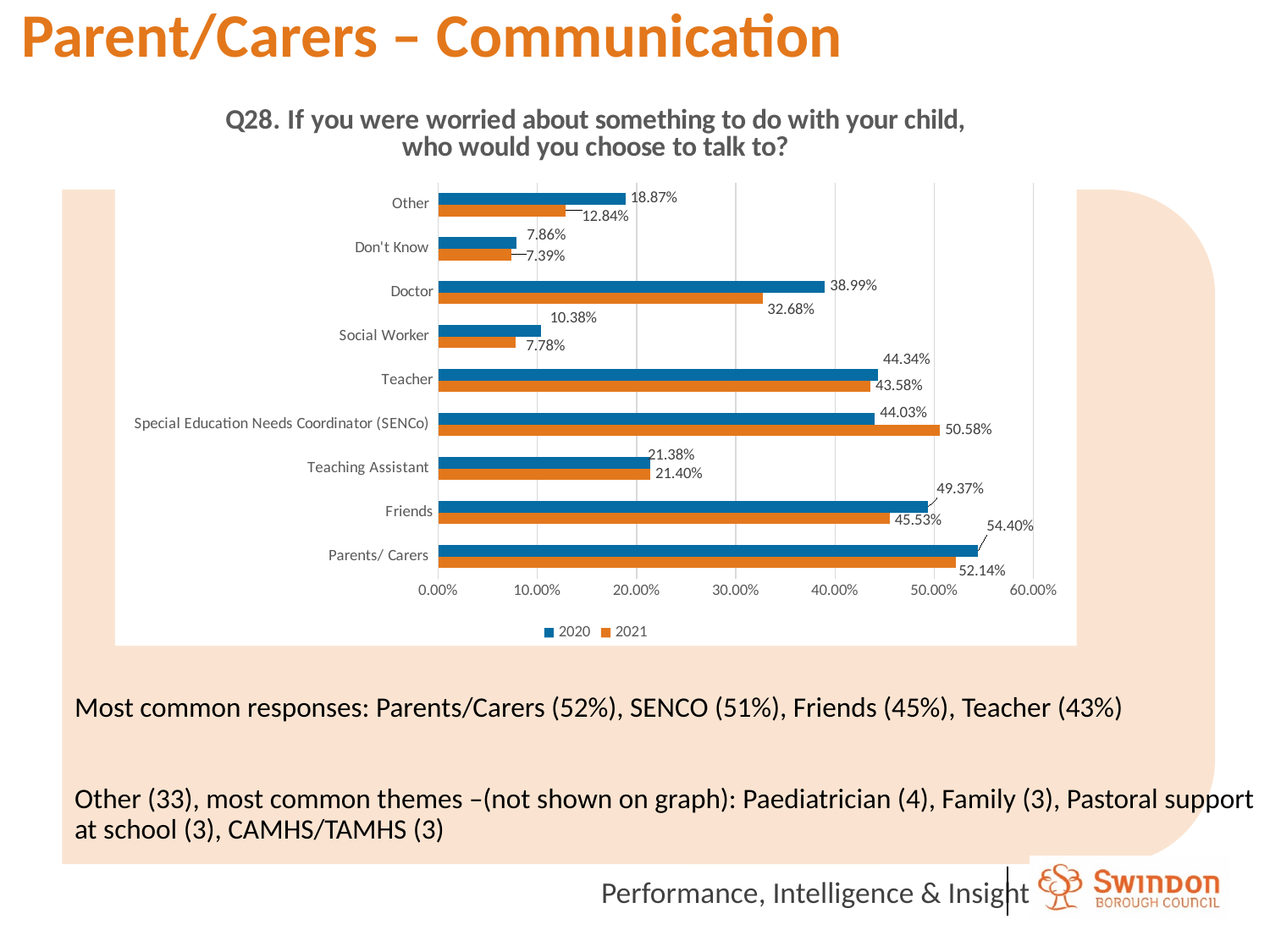
What kind of chart is shown on the slide? Bar chart What is the 2021 value for Doctor? 32.68% For Special Education Needs Coordinator (SENCo), which year has the larger value, 2020 or 2021? 2021 What is the 2021 value for Special Education Needs Coordinator (SENCo)? 50.58% Which category has the lowest 2020 value? Don't Know What is the 2020 value for Friends? 49.37% Is the 2020 value for Parents/ Carers greater or less than 50.00%? greater How many series does the legend list? 2 What is the difference between the 2020 and 2021 values for Other? 6.03% Which category has the highest 2021 value? Parents/ Carers What is the difference between the 2020 and 2021 values for Doctor? 6.31% How many categories are shown on the chart? 9